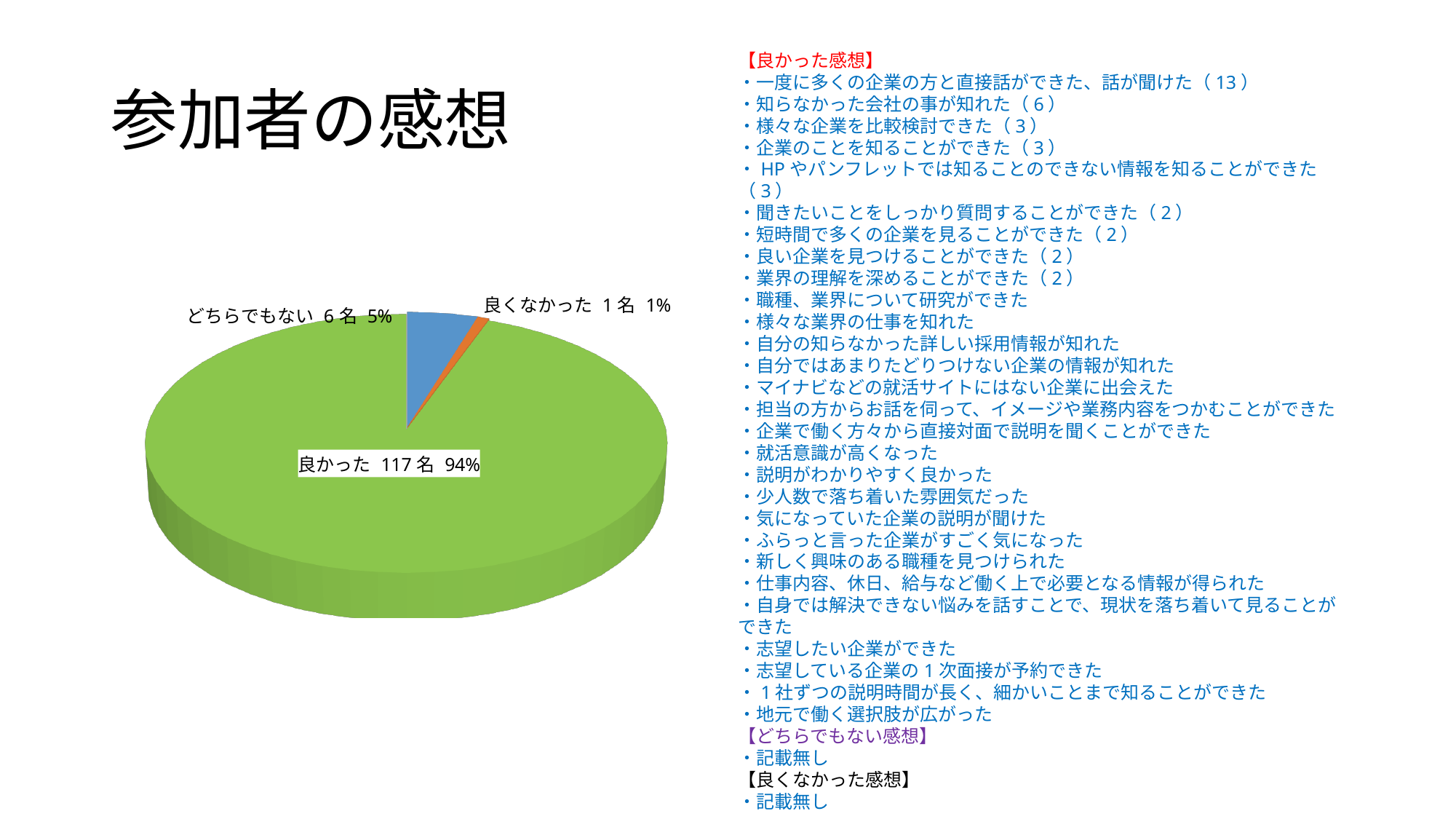
How many slices does the pie chart have? 3 How many people answered 良くなかった according to the pie chart? 1名 How many people answered どちらでもない according to the pie chart? 6名 Which category has the smallest slice in the pie chart? 良くなかった What percentage of the pie does どちらでもない represent? 5% Which category has the largest slice in the pie chart? 良かった Which slice is larger, どちらでもない or 良くなかった? どちらでもない What kind of chart is shown on the slide? Pie chart How many people answered 良かった according to the pie chart? 117名 How many more people answered どちらでもない than 良くなかった? 5名 What percentage of the pie does 良くなかった represent? 1% What percentage of the pie does 良かった represent? 94%